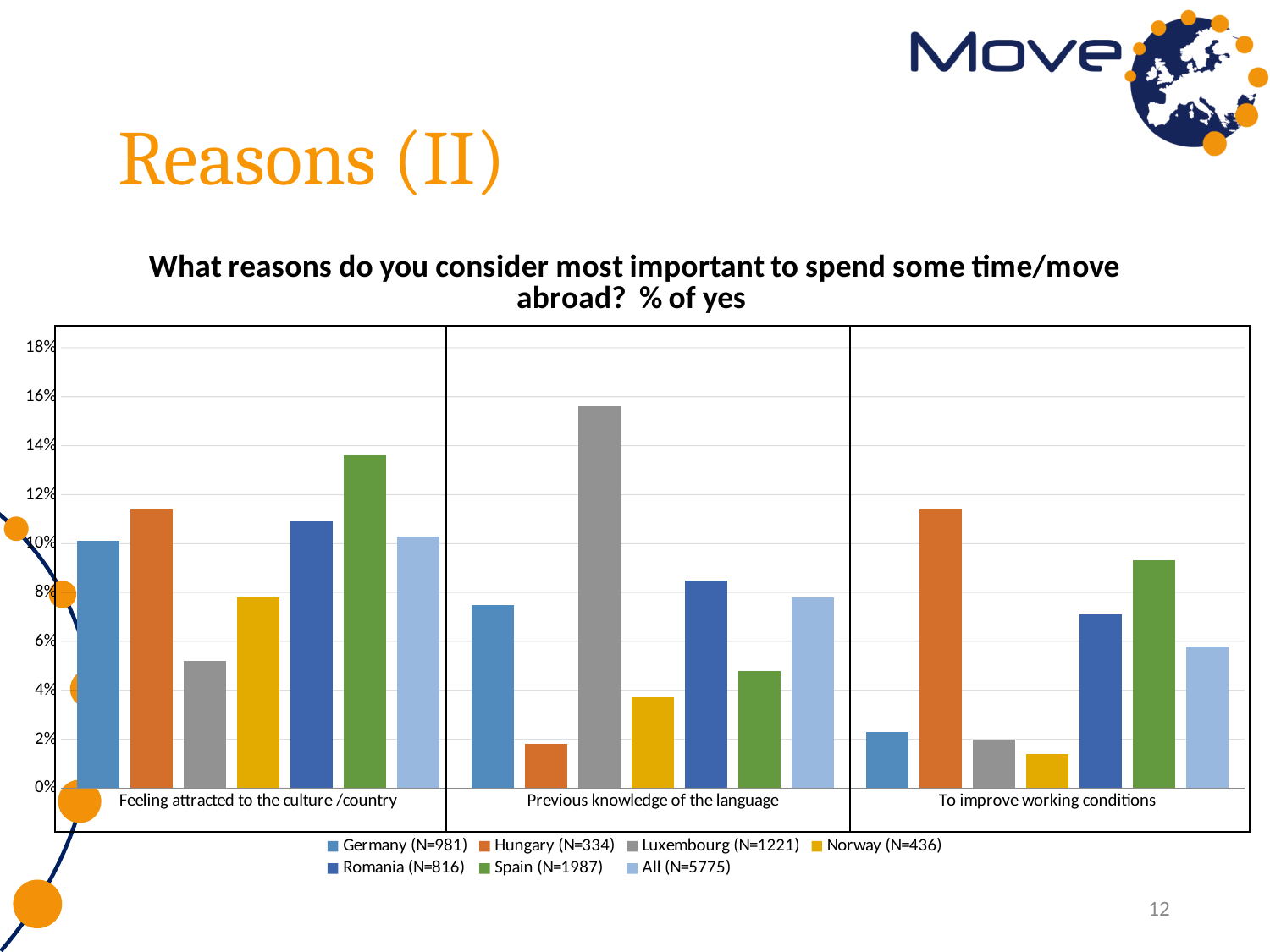
Is the value for Luxembourg (N=1221) under 'Previous knowledge of the language' greater or less than 14%? greater Is the value for Spain (N=1987) under 'Feeling attracted to the culture /country' greater or less than 12%? greater Which series has the highest value for 'Feeling attracted to the culture /country'? Spain (N=1987) How many reason categories are shown on the x axis? 3 Under 'To improve working conditions', which is larger: Germany (N=981) or Hungary (N=334)? Hungary (N=334) How many series does the legend list? 7 Which series has the highest value for 'Previous knowledge of the language'? Luxembourg (N=1221) Which series has the lowest value for 'To improve working conditions'? Norway (N=436) Which series has the lowest value for 'Feeling attracted to the culture /country'? Luxembourg (N=1221) Which series has the highest value for 'To improve working conditions'? Hungary (N=334) What kind of chart is shown on the slide? bar chart Which series has the lowest value for 'Previous knowledge of the language'? Hungary (N=334)